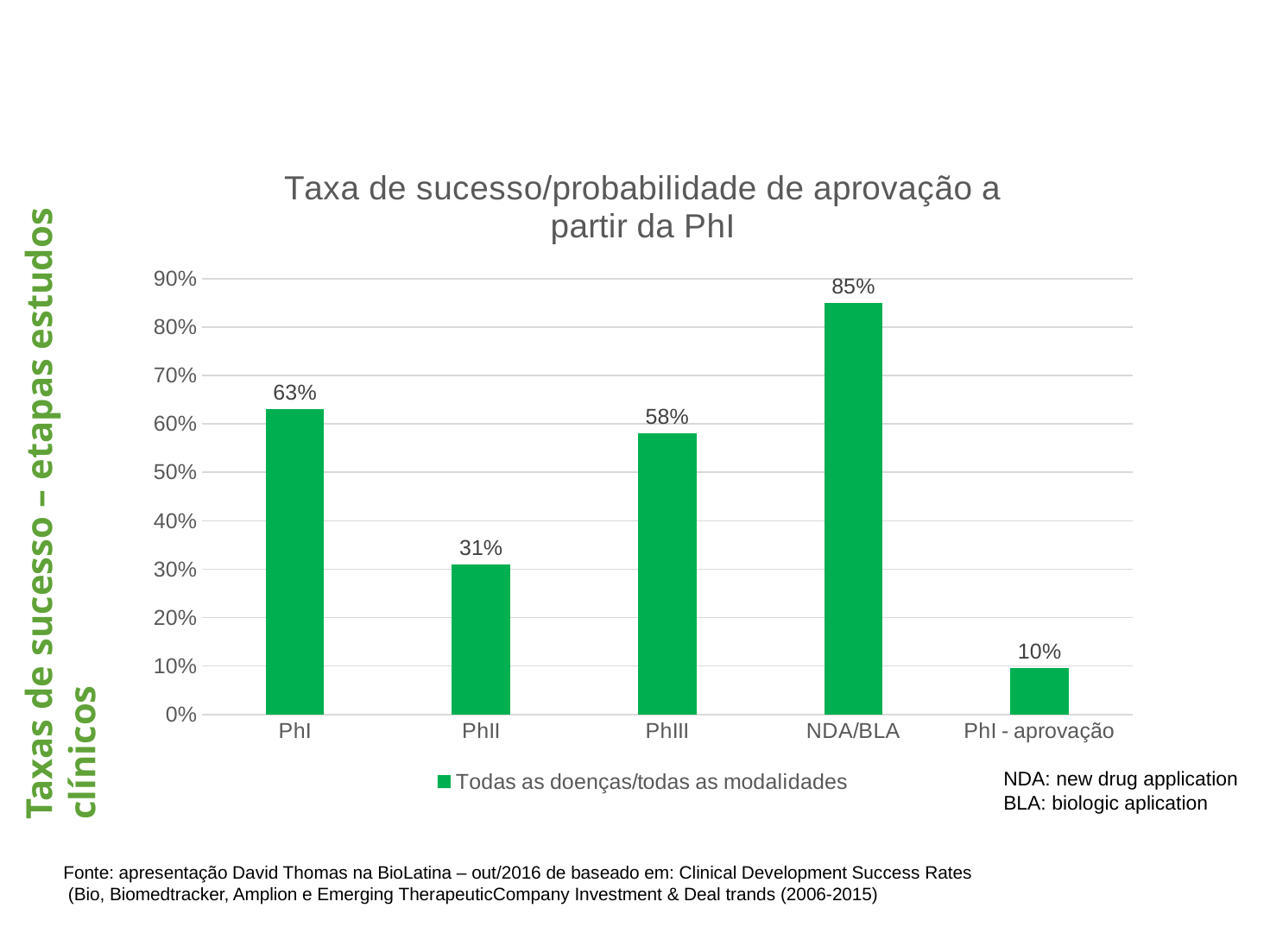
Which category has the lowest value? PhI - aprovação What is the value for NDA/BLA? 85% How many series does the legend list? 1 Which category has the highest value? NDA/BLA What is the legend entry for the series? Todas as doenças/todas as modalidades Which is larger, the value for PhI or the value for PhIII? PhI What is the difference between the values for NDA/BLA and PhIII? 27% What is the value for PhI? 63% How many categories are shown on the x axis? 5 What is the value for PhI - aprovação? 10% What is the value for PhII? 31% What kind of chart is shown? bar chart